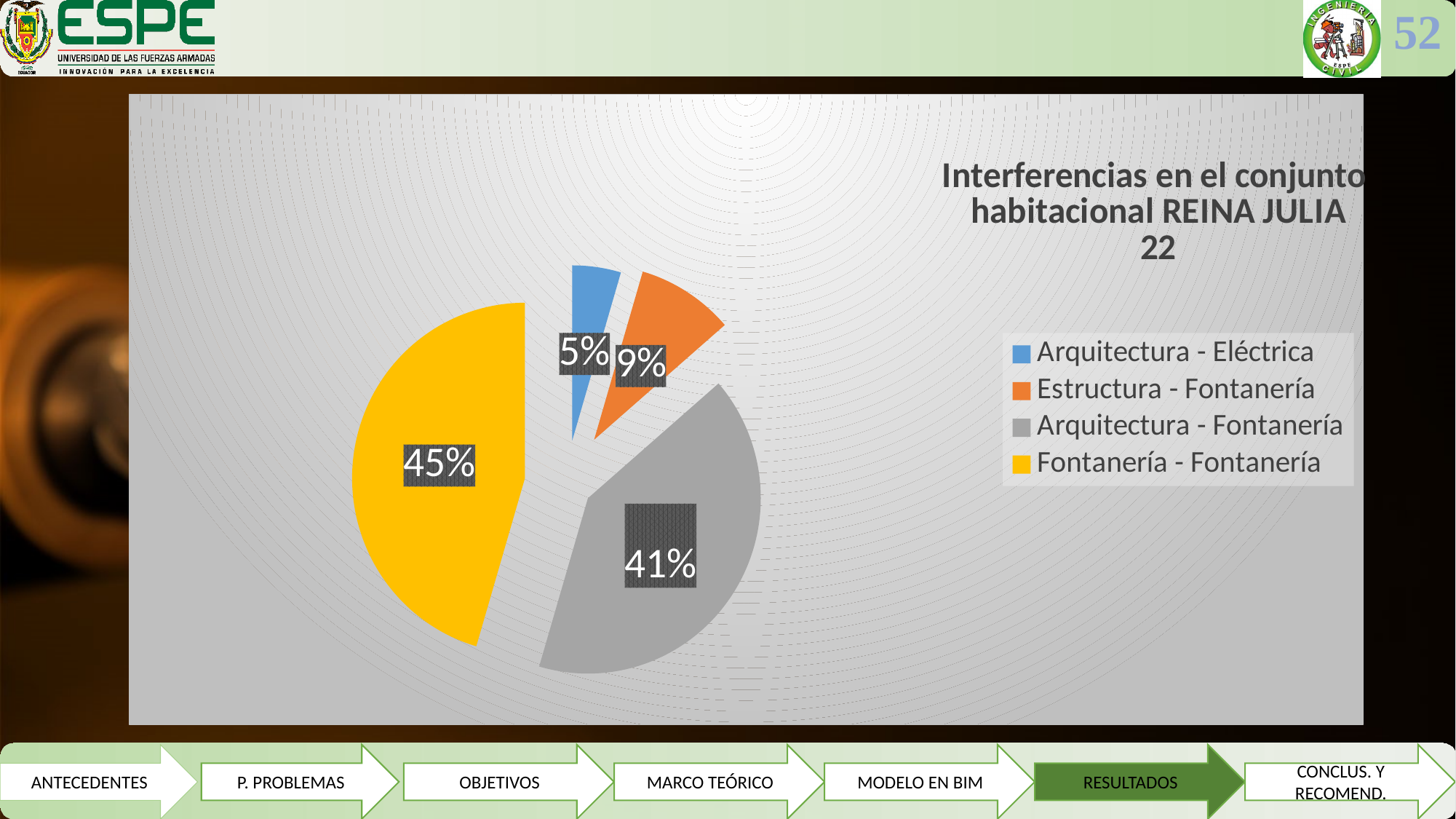
Which category has the largest slice of the pie? Fontanería - Fontanería Which is larger, the share for Estructura - Fontanería or the share for Arquitectura - Eléctrica? Estructura - Fontanería What colour is the slice for Arquitectura - Fontanería? gray What percentage of the pie does Arquitectura - Fontanería represent? 41% What percentage of the pie does Arquitectura - Eléctrica represent? 5% Which category has the smallest slice of the pie? Arquitectura - Eléctrica What percentage of the pie does Estructura - Fontanería represent? 9% What is the title of the chart? Interferencias en el conjunto habitacional REINA JULIA 22 What is the difference in percentage points between Fontanería - Fontanería and Arquitectura - Fontanería? 4 How many categories does the pie chart have? 4 What kind of chart is shown on the slide? pie chart